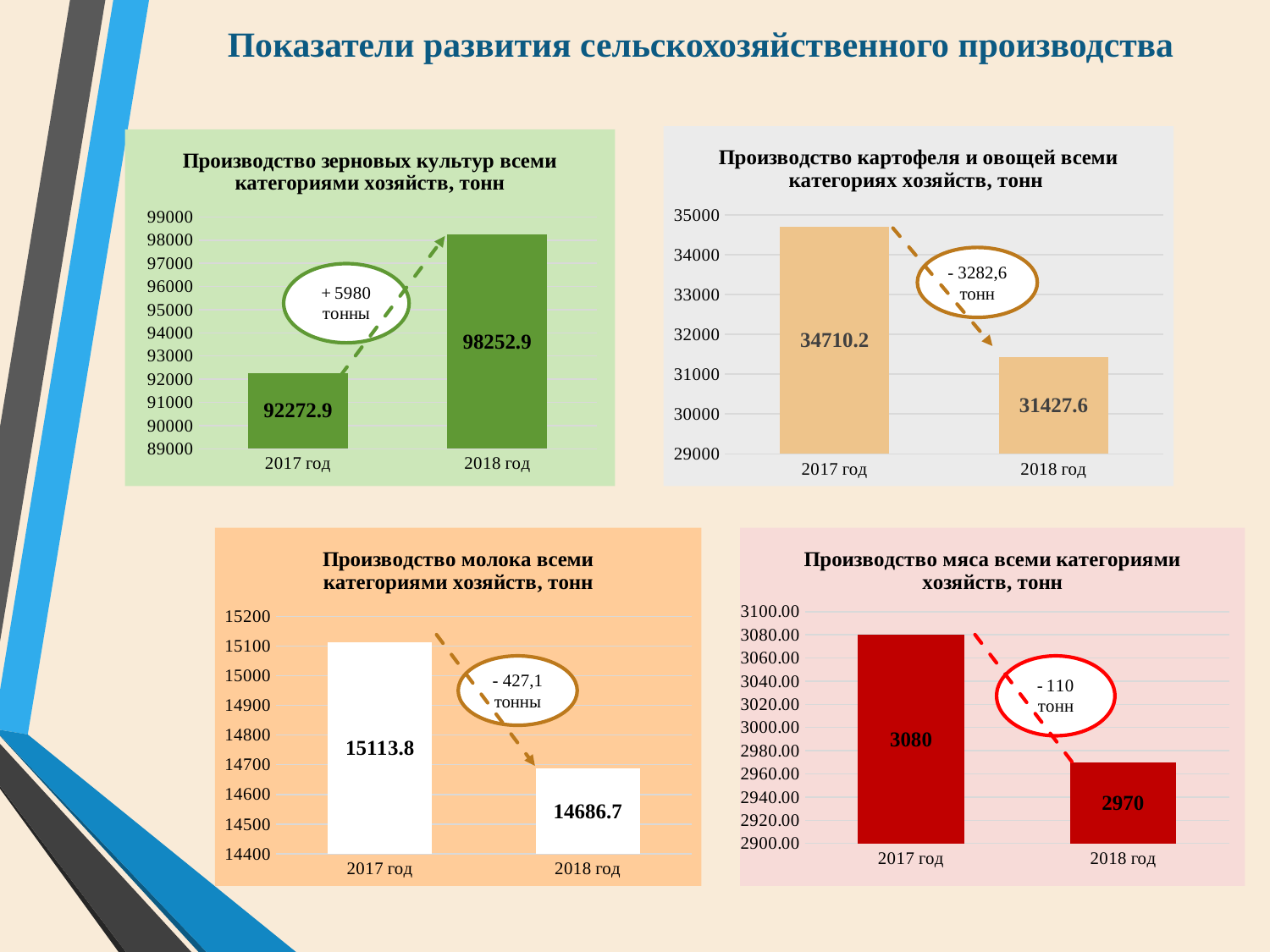
In the chart 'Производство молока всеми категориями хозяйств, тонн', how many categories are shown on the x axis? 2 In the chart 'Производство картофеля и овощей всеми категориях хозяйств, тонн', what is the value for 2017 год? 34710.2 In the chart 'Производство мяса всеми категориями хозяйств, тонн', what is the value for 2017 год? 3080 In the chart 'Производство зерновых культур всеми категориями хозяйств, тонн', do the values rise or fall from 2017 год to 2018 год? rise In the chart 'Производство молока всеми категориями хозяйств, тонн', what is the value for 2018 год? 14686.7 In the chart 'Производство картофеля и овощей всеми категориях хозяйств, тонн', which year has the lower value? 2018 год What kind of chart is 'Производство мяса всеми категориями хозяйств, тонн'? bar chart In the chart 'Производство зерновых культур всеми категориями хозяйств, тонн', what is the value for 2018 год? 98252.9 In the chart 'Производство мяса всеми категориями хозяйств, тонн', what is the difference between the 2017 год and 2018 год values? 110 In the chart 'Производство зерновых культур всеми категориями хозяйств, тонн', what is the value for 2017 год? 92272.9 In the chart 'Производство молока всеми категориями хозяйств, тонн', which year has the higher value? 2017 год In the chart 'Производство картофеля и овощей всеми категориях хозяйств, тонн', what is the difference between the 2017 год and 2018 год values? 3282.6